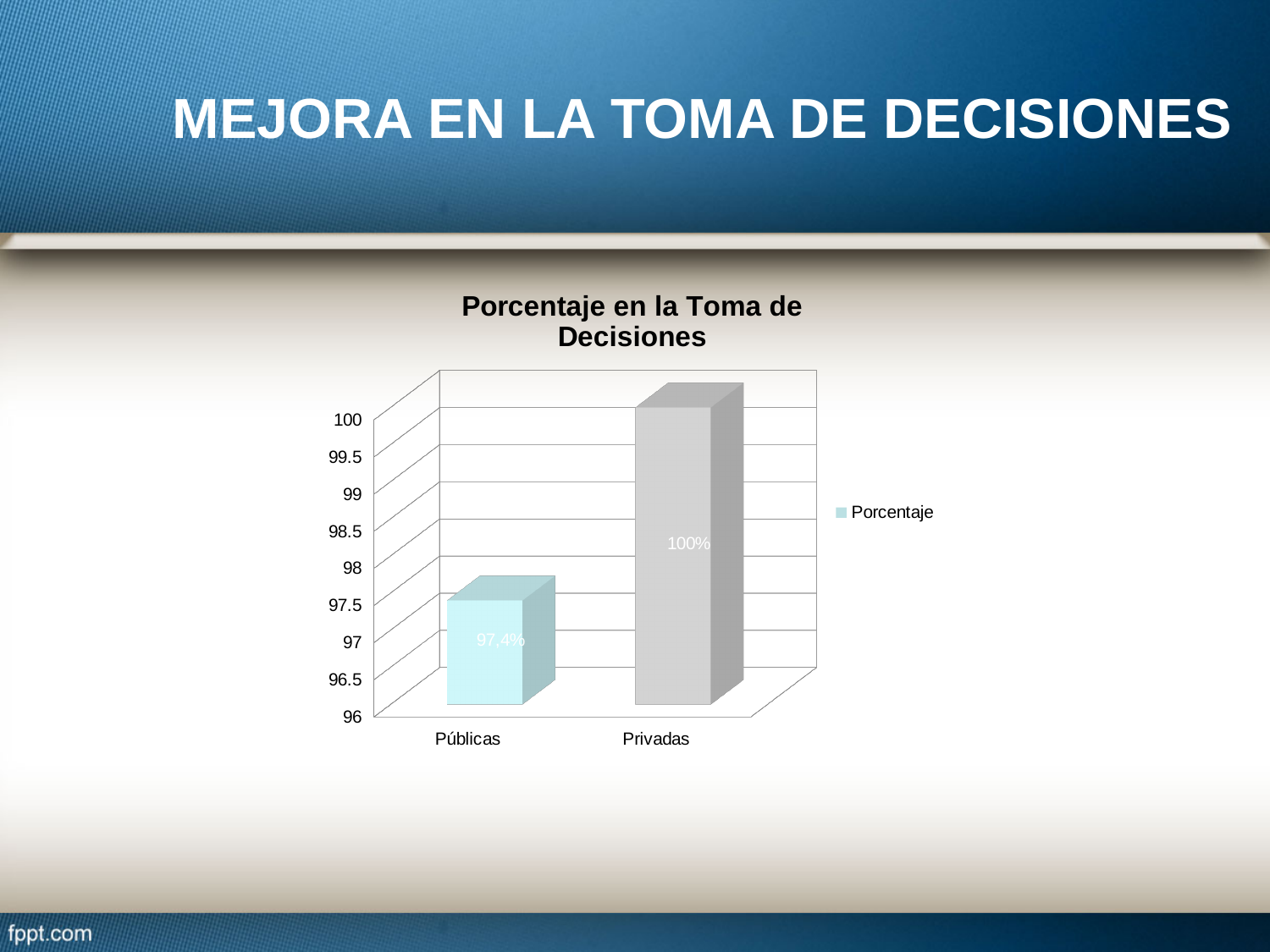
Is the value for Públicas greater or less than 98? less What is the value for Privadas? 100% How many categories are shown on the x axis? 2 What is the value for Públicas? 97,4% How many series does the legend list? 1 Which is larger, the value for Públicas or the value for Privadas? Privadas What kind of chart is shown? bar chart Is the value for Privadas greater or less than 99? greater Which category has the lowest value? Públicas What is the name of the series in the legend? Porcentaje What is the title of the chart? Porcentaje en la Toma de Decisiones Which category has the highest value? Privadas